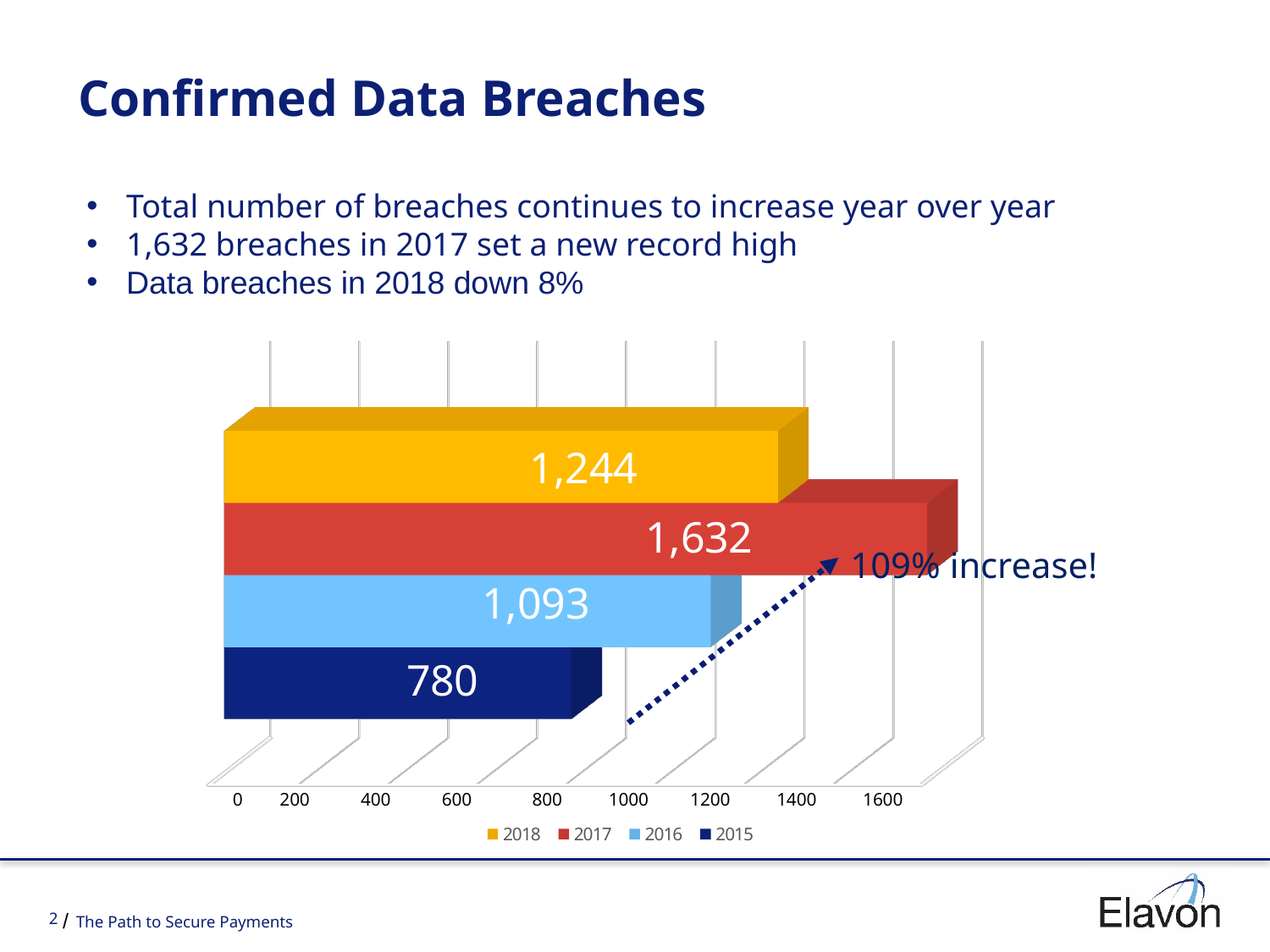
How many series does the legend list? 4 What is the difference between the values for 2016 and 2015? 313 Which is larger, the value for 2018 or the value for 2016? 2018 What kind of chart is shown on the slide? bar chart What is the value for 2015? 780 What is the value for 2017? 1,632 What is the difference between the values for 2017 and 2018? 388 What colour is the bar for 2017? red Which year has the highest number of breaches? 2017 What is the value for 2018? 1,244 What is the value for 2016? 1,093 Which year has the lowest number of breaches? 2015